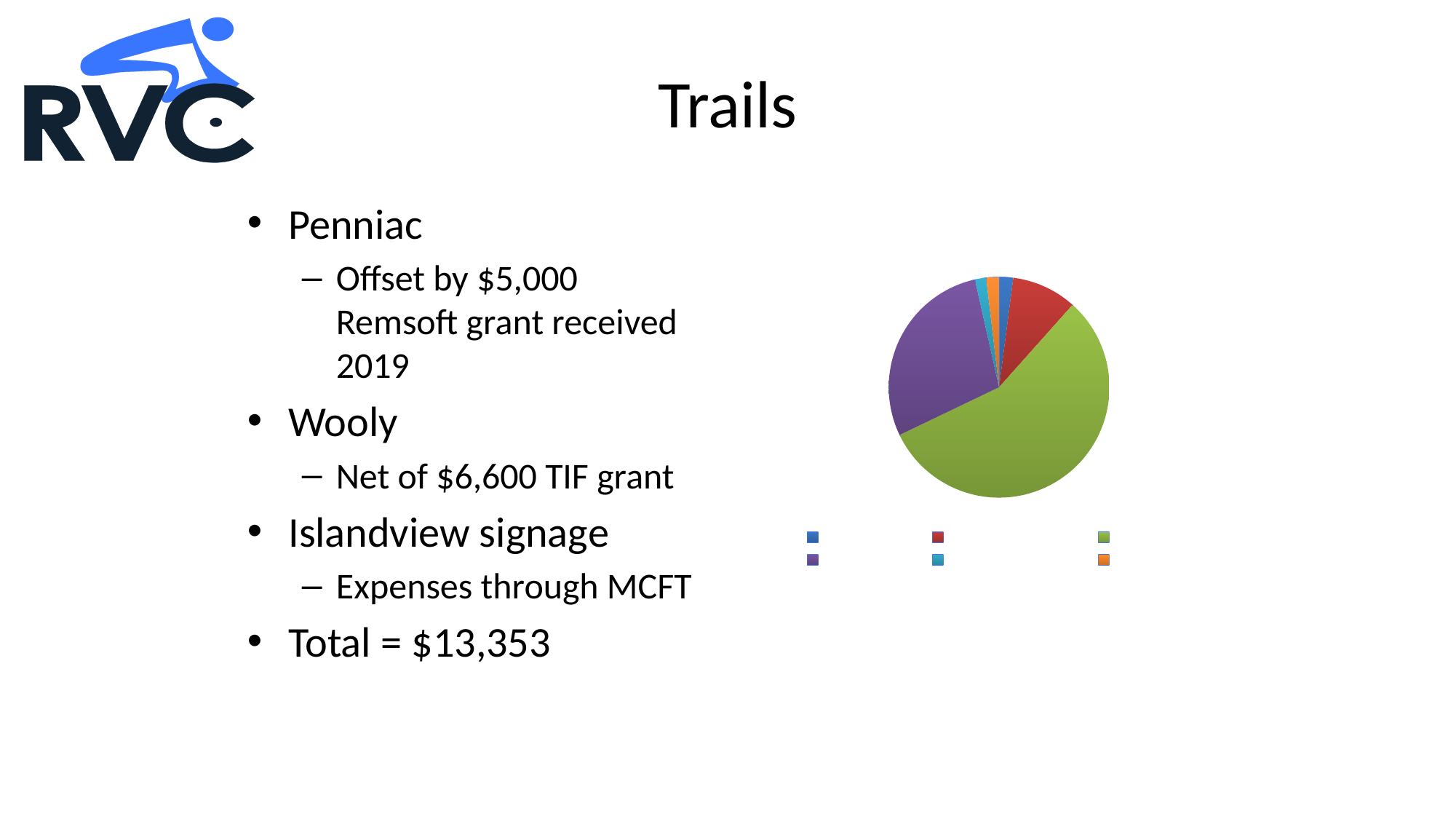
How many slices does the pie chart have? 6 Which is larger in the pie chart, the red slice or the purple slice? purple Does the green slice make up more or less than half of the pie chart? more Which is larger in the pie chart, the green slice or the purple slice? green What kind of chart is shown on the slide? pie chart Which colour slice is the largest in the pie chart? green How many entries does the pie chart's legend list? 6 Where is the pie chart positioned on the slide, left or right of the bullet text? right Which is larger in the pie chart, the red slice or the dark blue slice? red